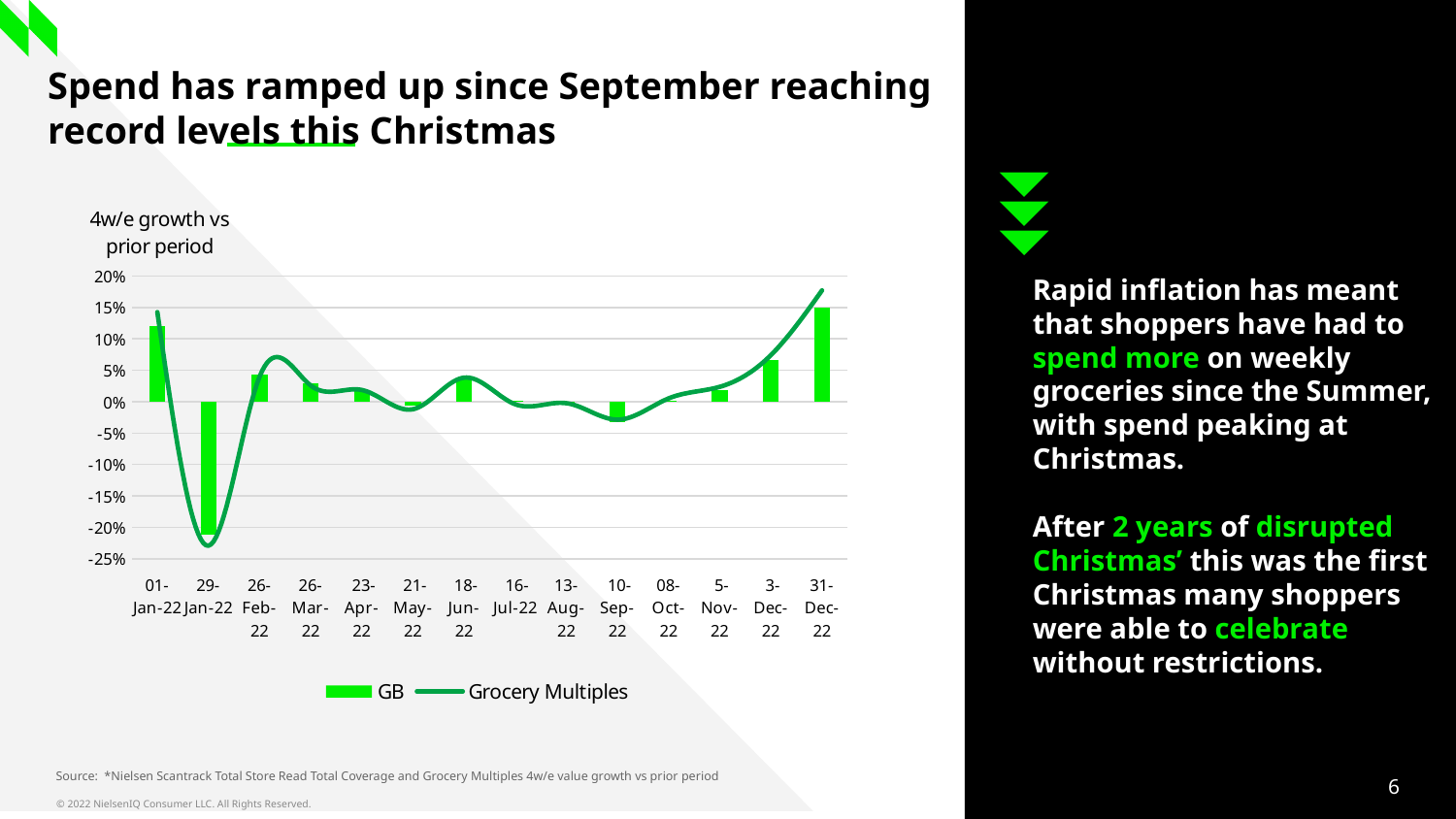
Do the GB values rise or fall from 10-Sep-22 to 31-Dec-22? rise Is the GB value for 29-Jan-22 greater or less than -15%? less What are the two series named in the chart legend? GB and Grocery Multiples Which period has the lowest GB bar? 29-Jan-22 Is the Grocery Multiples value for 31-Dec-22 greater or less than 15%? greater How many dated periods are shown along the x axis of the chart? 14 Is the GB value for 31-Dec-22 greater or less than 10%? greater At 31-Dec-22, which is higher, the GB bar or the Grocery Multiples line? Grocery Multiples What kind of chart is shown on the slide? A combination bar and line chart Which is larger, the GB value for 3-Dec-22 or the GB value for 5-Nov-22? 3-Dec-22 How many series does the chart legend list? 2 Which period has the highest GB bar? 31-Dec-22